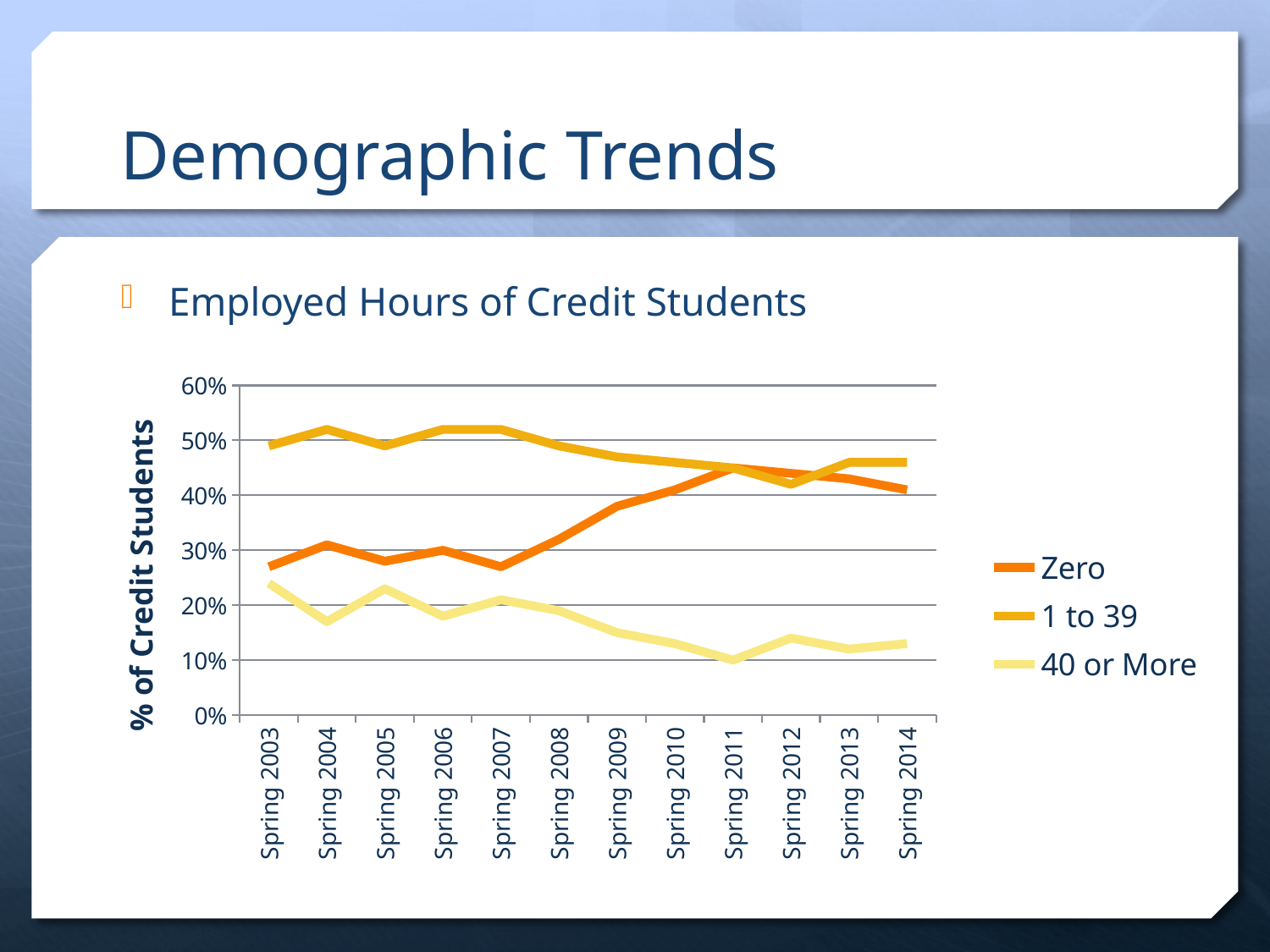
What are the three series named in the legend? Zero, 1 to 39, 40 or More Is the value for Zero in Spring 2003 greater or less than 30%? less Is the value for 40 or More in Spring 2009 greater or less than 20%? less What kind of chart is shown on the slide? Line chart In which period does the 40 or More series reach its lowest value? Spring 2011 How many series does the legend list? 3 Does the 40 or More series generally rise or fall from Spring 2003 to Spring 2014? Fall Is the value for Zero in Spring 2011 greater or less than 40%? greater What is the title of the vertical axis? % of Credit Students How many points are plotted along the x axis for each series? 12 In Spring 2014, which series has the larger value, Zero or 1 to 39? 1 to 39